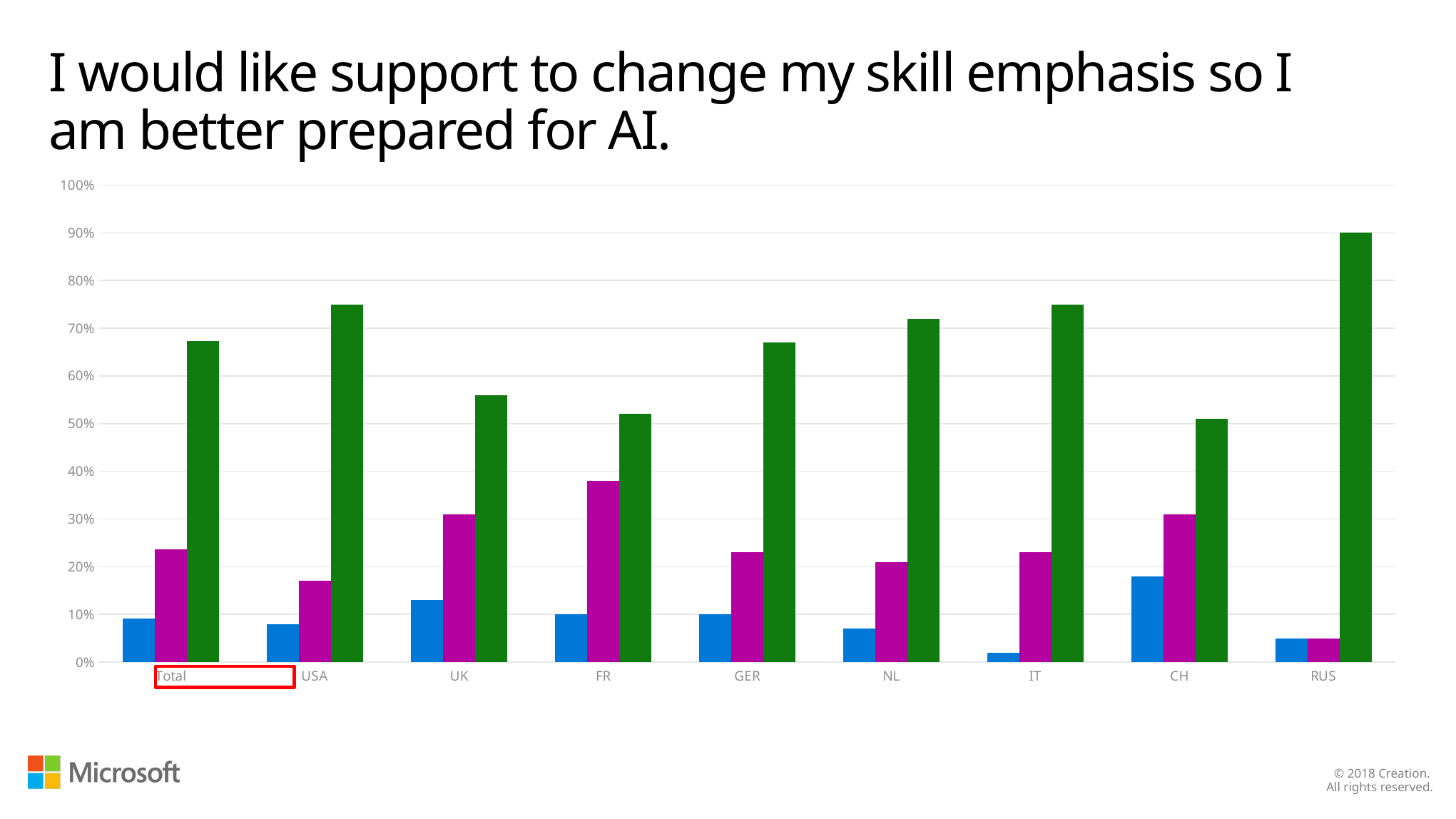
Is the green bar for Total greater or less than 60%? greater What is the value of the green bar for RUS? 90% Is the blue bar for IT greater or less than 10%? less How many categories are shown along the x axis? 9 Which category has the highest blue bar? CH Is the magenta bar for FR greater or less than 30%? greater What kind of chart is shown on the slide? bar chart Which category has the highest magenta bar? FR Which has the larger green bar, USA or UK? USA Which category has the highest green bar? RUS Which has the larger magenta bar, FR or GER? FR Which category has the lowest blue bar? IT